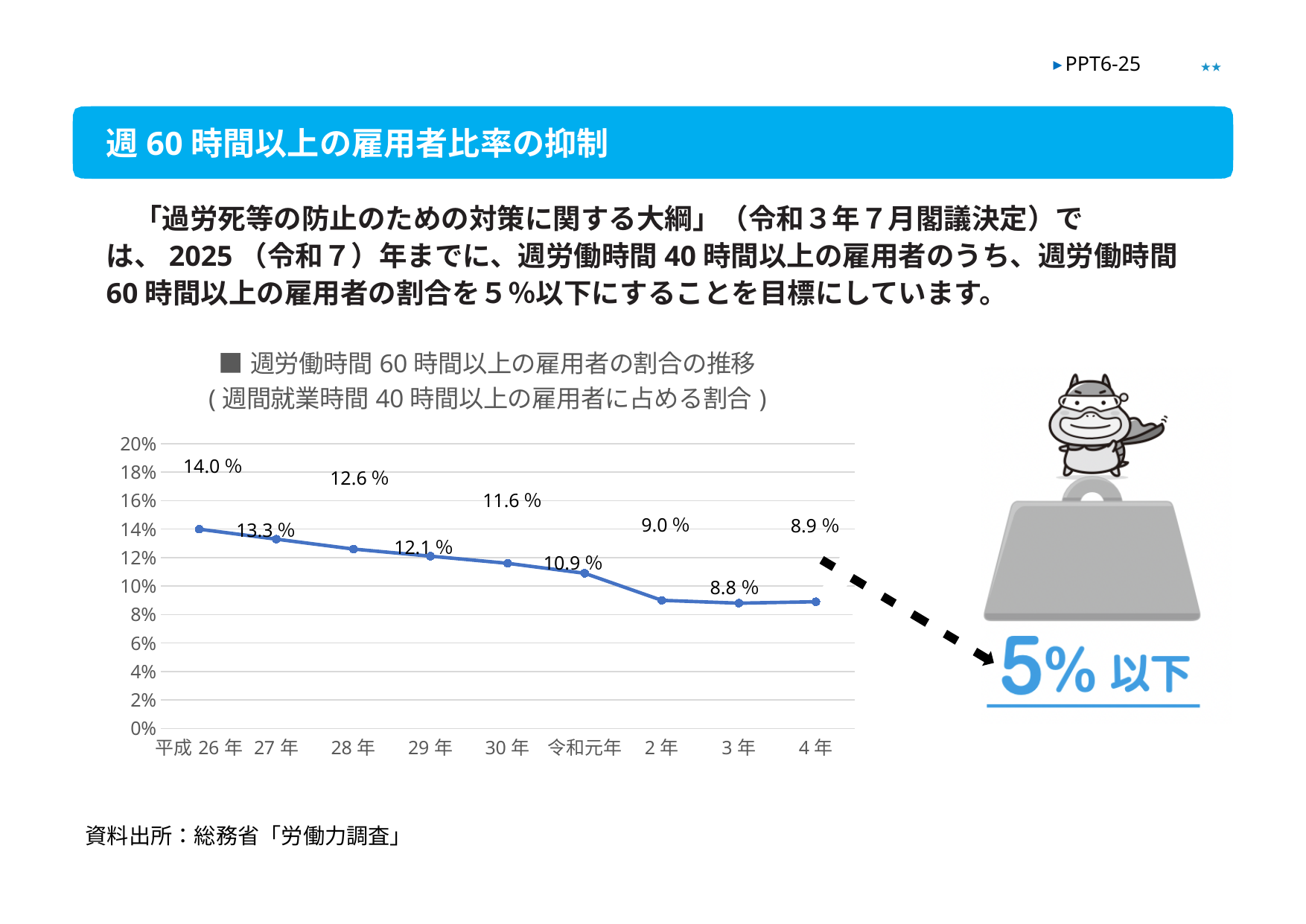
What is the difference between the values for 平成26年 and 令和4年? 5.1% What is the value for 令和元年 in the chart? 10.9% Is the value for 平成30年 greater or less than 10%? greater What kind of chart is shown on the slide? line chart What is the target percentage shown to the right of the chart? 5%以下 What is the value for 平成26年 in the chart? 14.0% How many data points are plotted in the chart? 9 Which is larger, the value for 平成28年 or the value for 令和2年? 平成28年 Which year has the highest value in the chart? 平成26年 What is the value for 令和4年 in the chart? 8.9% Which year has the lowest value in the chart? 令和3年 Do the values generally rise or fall from 平成26年 to 令和4年? fall